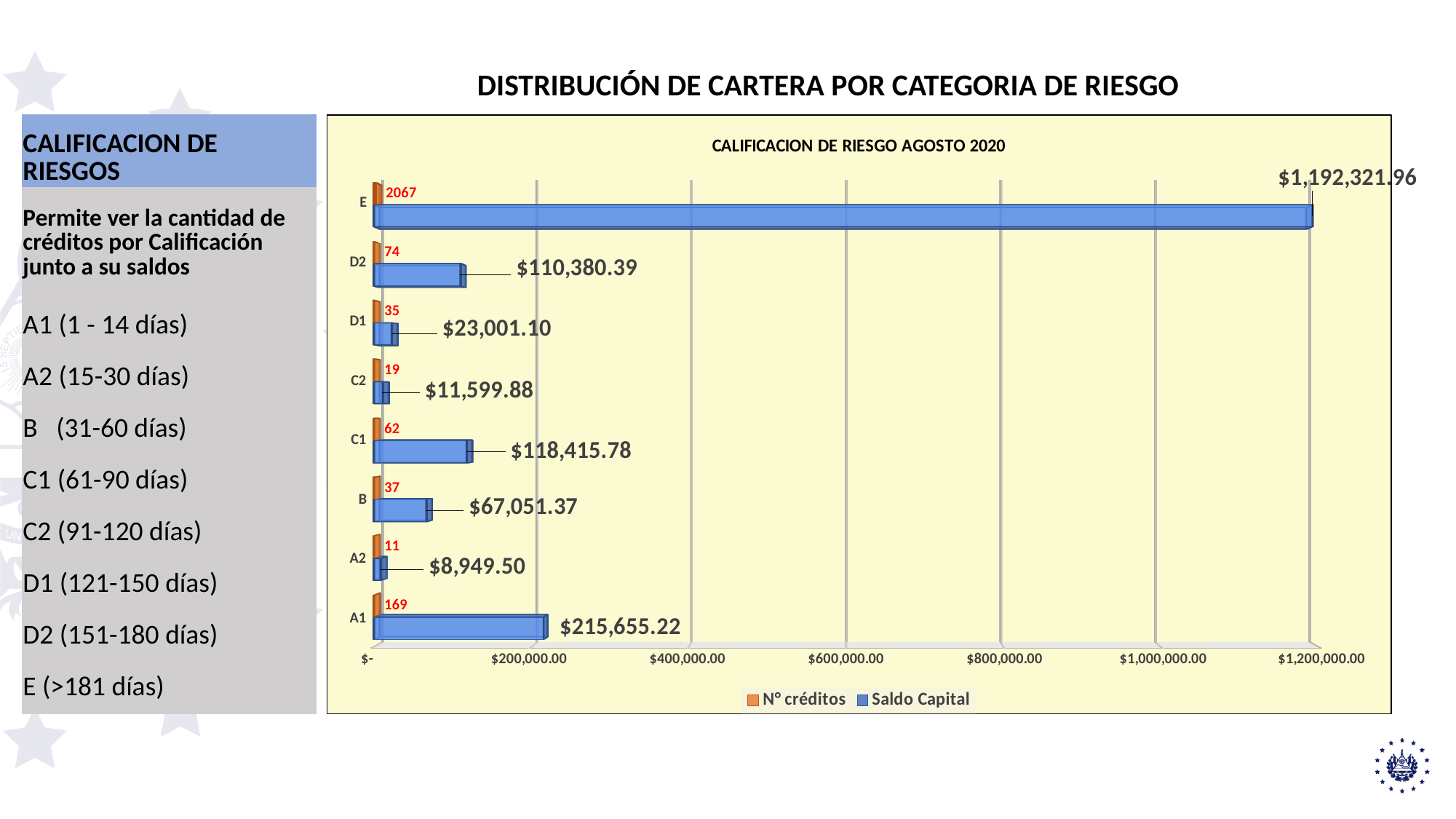
Which has a larger Saldo Capital, D2 or C1? C1 What is the title of the chart? CALIFICACION DE RIESGO AGOSTO 2020 What is the difference in Saldo Capital between A1 and B? $148,603.85 What is the N° créditos value for category A1? 169 What is the Saldo Capital for category C1? $118,415.78 How many risk categories are shown on the chart? 8 What kind of chart is shown? Bar chart Which category has the highest Saldo Capital? E What is the Saldo Capital for category E? $1,192,321.96 How many series does the legend list? 2 What is the N° créditos value for category D2? 74 Which category has the lowest N° créditos? A2